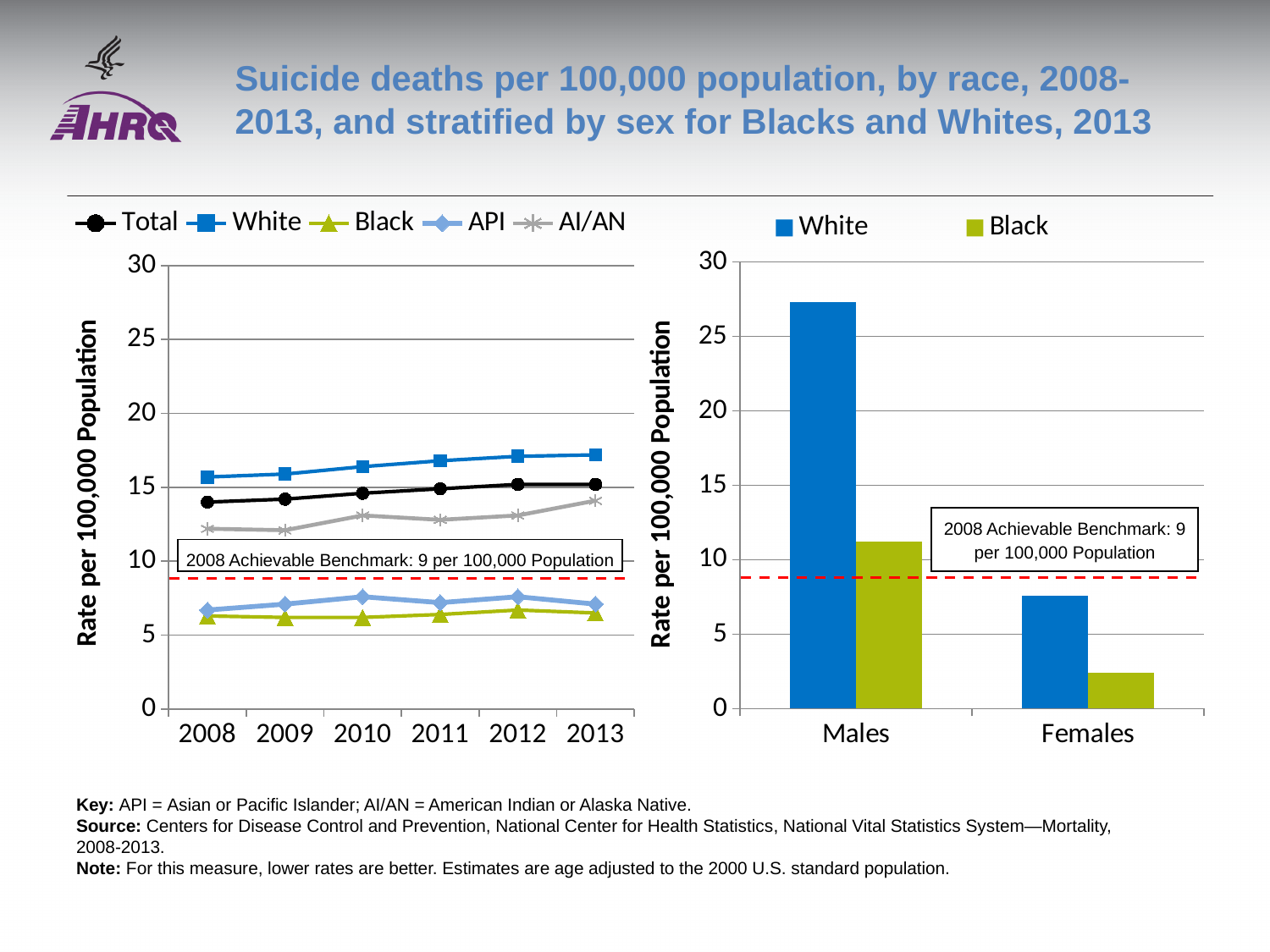
In the left chart, is the value for Black in 2008 greater or less than 10? less In the right chart, which bar is the highest? White Males In the left chart, how many years are plotted along the x axis? 6 What kind of chart is the left chart showing suicide deaths by race from 2008 to 2013? line chart In the left chart, which race group has the highest suicide death rate in 2013? White In the left chart, does the White rate rise or fall from 2008 to 2013? rise What is the 2008 Achievable Benchmark shown by the dashed line on both charts? 9 per 100,000 Population In the left chart, how many series does the legend list? 5 In the left chart, is the value for White in 2013 greater or less than 15? greater In the right chart, which bar is the lowest? Black Females In the right chart, is the value for White Males greater or less than 25? greater What kind of chart is the right chart showing rates for Males and Females? bar chart